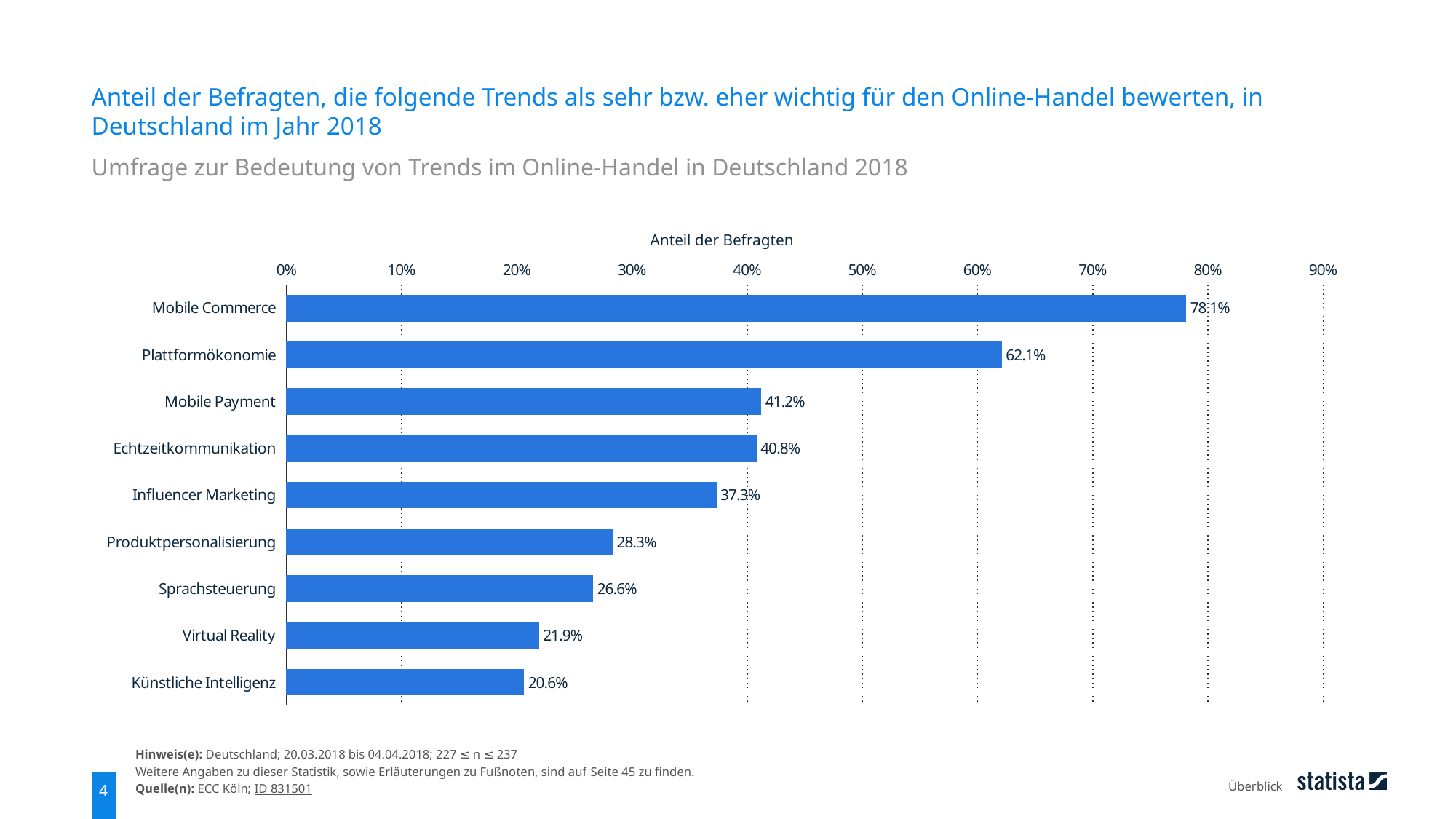
What kind of chart is shown on the slide? Bar chart What is the difference between the values for Mobile Commerce and Plattformökonomie? 16 percentage points What is the value for Influencer Marketing? 37.3% What is the value for Mobile Commerce? 78.1% What is the value for Sprachsteuerung? 26.6% What is the difference between the values for Virtual Reality and Künstliche Intelligenz? 1.3 percentage points What is the label of the value axis? Anteil der Befragten Which is larger, the value for Produktpersonalisierung or the value for Sprachsteuerung? Produktpersonalisierung Which trend has the lowest share of respondents? Künstliche Intelligenz How many trends are shown in the chart? 9 Is the value for Plattformökonomie greater or less than 60%? greater Which trend has the highest share of respondents? Mobile Commerce